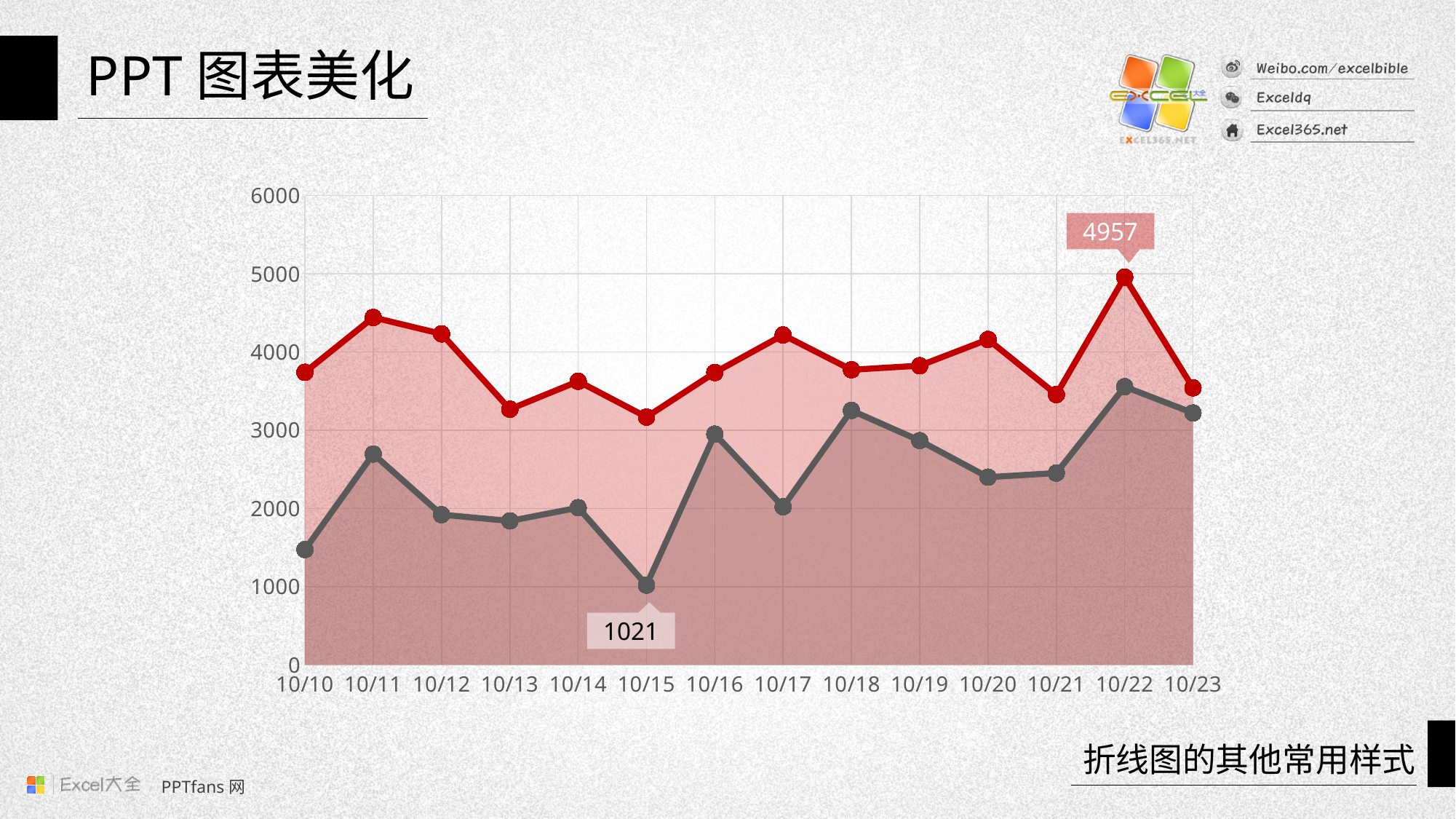
On which date does the red line reach its highest value? 10/22 How many dates are plotted along the x axis? 14 Is the value of the gray line on 10/10 greater or less than 2000? less What kind of chart is shown on the slide? line chart Is the value of the red line on 10/11 greater or less than 4000? greater How many lines are plotted on the chart? 2 On which date does the gray line reach its highest value? 10/22 What is the labelled value of the gray line on 10/15? 1021 What is the difference between the labelled value 4957 on the red line and the labelled value 1021 on the gray line? 3936 On which date does the gray line reach its lowest value? 10/15 On 10/16, which line has the larger value, the red line or the gray line? red line What is the labelled value of the red line on 10/22? 4957